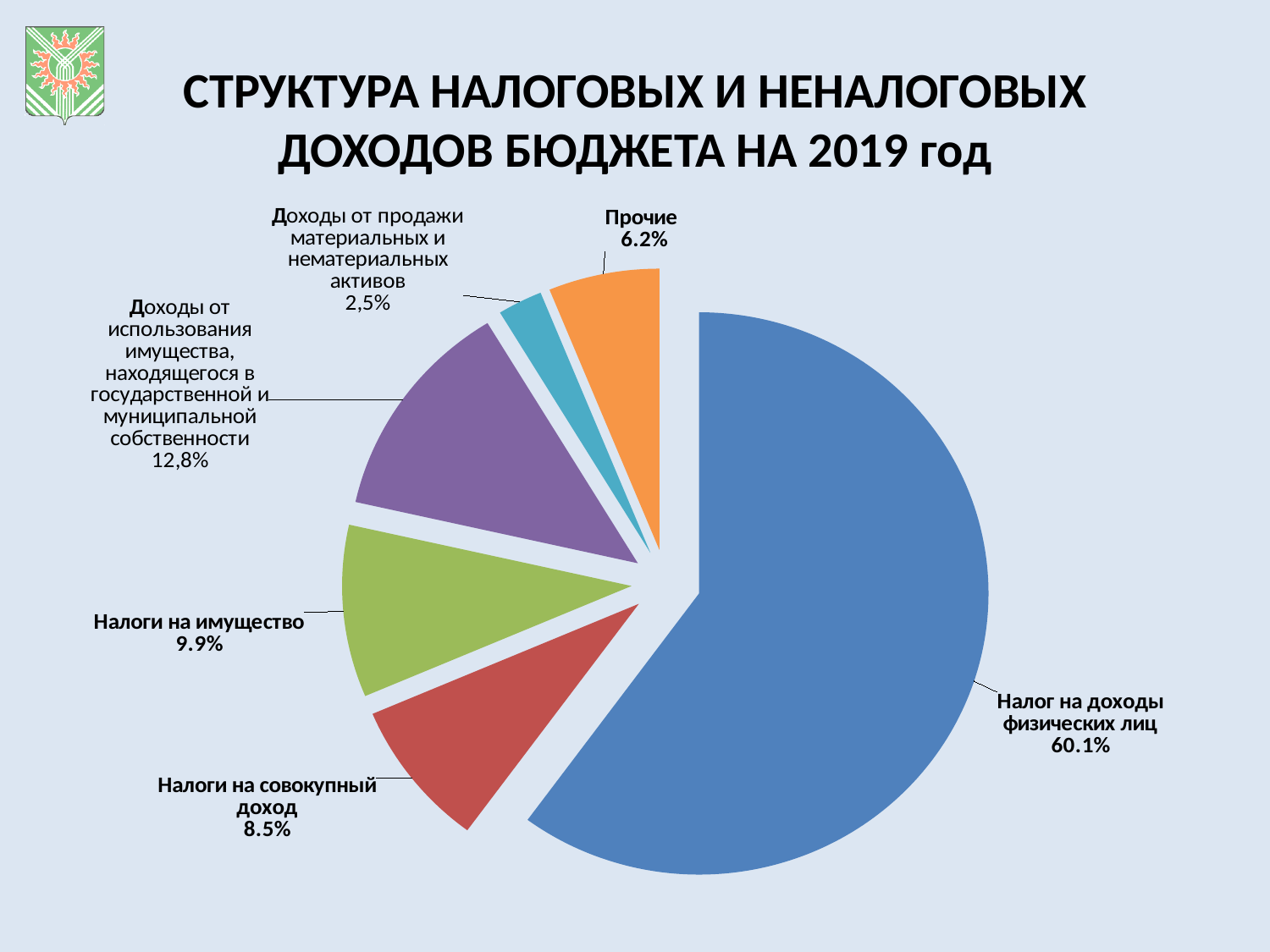
What share of the pie does "Налог на доходы физических лиц" have? 60.1% Which category has the smallest share of the pie? Доходы от продажи материальных и нематериальных активов What type of chart is shown on the slide? Pie chart Which category has the largest share of the pie? Налог на доходы физических лиц What is the value shown for "Доходы от продажи материальных и нематериальных активов"? 2,5% What is the value shown for "Прочие"? 6.2% What is the value shown for "Налоги на имущество"? 9.9% What is the difference in percentage points between "Налоги на имущество" and "Налоги на совокупный доход"? 1.4 What is the value shown for "Налоги на совокупный доход"? 8.5% How many slices does the pie chart have? 6 Which is larger: "Налоги на имущество" or "Налоги на совокупный доход"? Налоги на имущество What is the value shown for "Доходы от использования имущества, находящегося в государственной и муниципальной собственности"? 12,8%